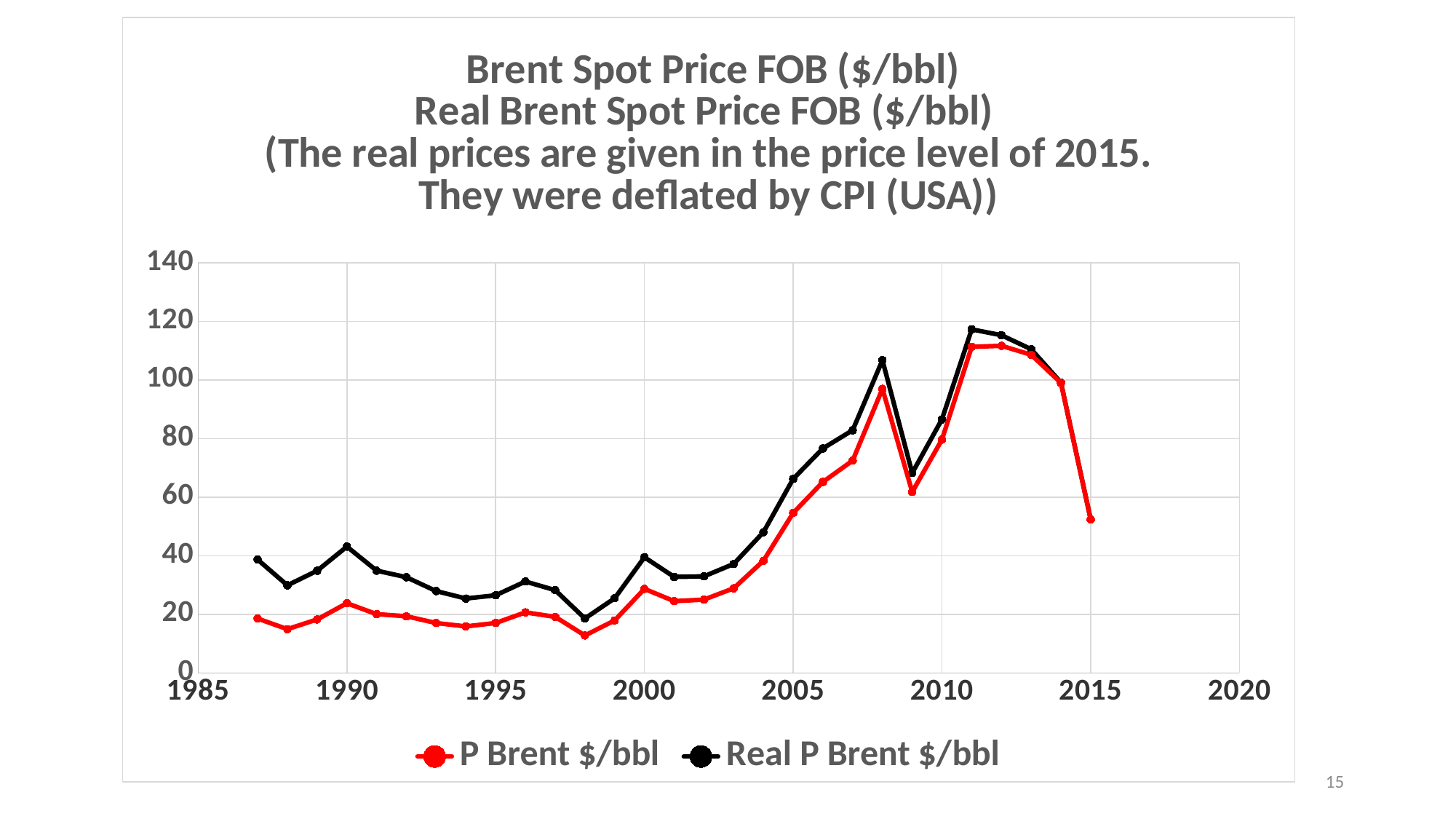
For the P Brent $/bbl series, which year has the higher value, 2008 or 2009? 2008 What kind of chart is shown on the slide? line chart In which year is the Real P Brent $/bbl series at its lowest? 1998 In 2000, which series has the higher value, P Brent $/bbl or Real P Brent $/bbl? Real P Brent $/bbl Is the P Brent $/bbl value for 1998 greater or less than 20? less Is the P Brent $/bbl value for 2015 greater or less than 60? less Does the P Brent $/bbl series rise or fall between 2012 and 2015? fall How many series does the legend list? 2 Which colour is used for the Real P Brent $/bbl series? black Is the Real P Brent $/bbl value for 2008 greater or less than 100? greater In which year is the P Brent $/bbl series at its lowest? 1998